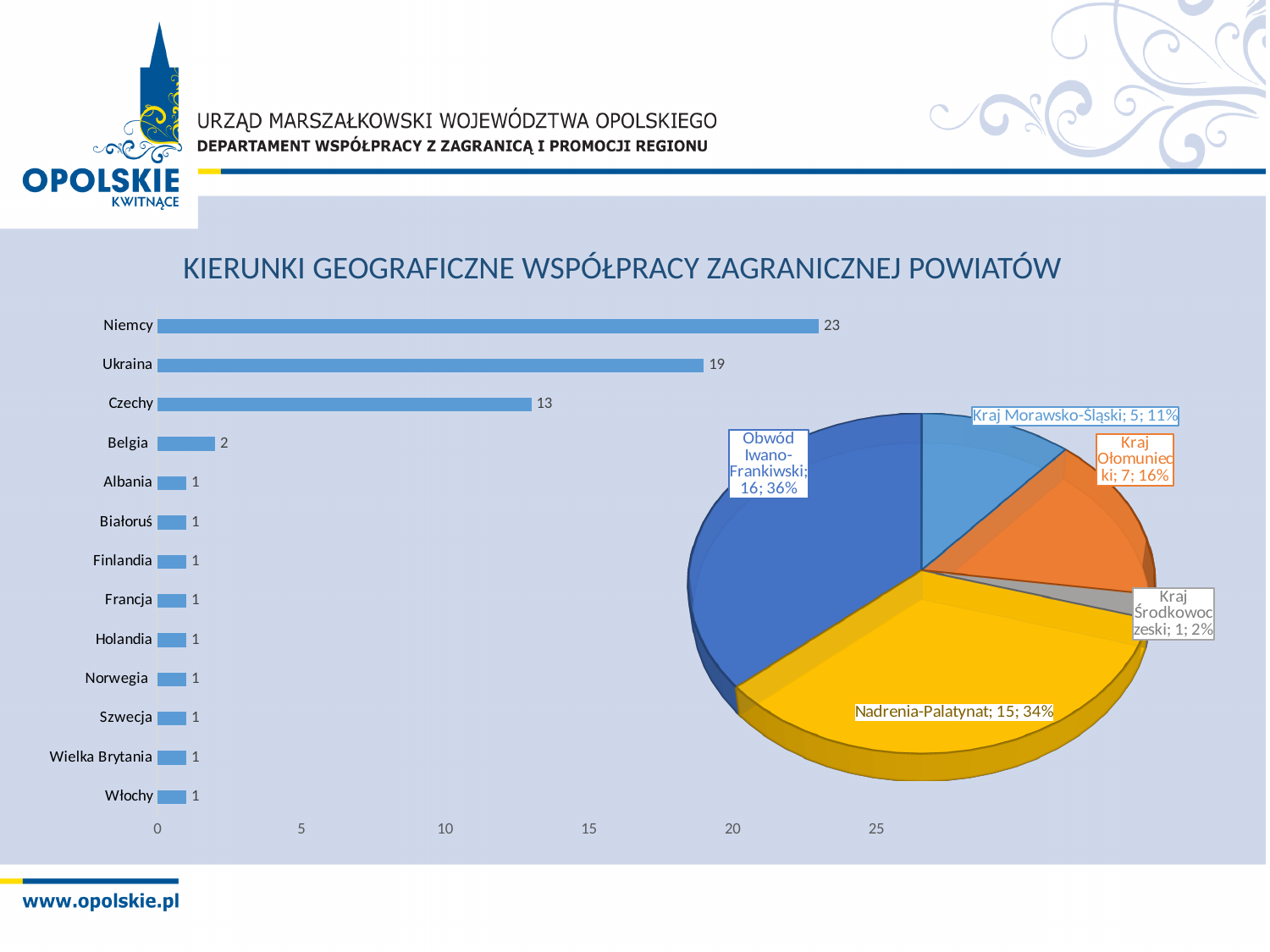
In the bar chart on the left, how many categories are shown? 13 In the bar chart on the left, which is larger, the value for Belgia or the value for Czechy? Czechy What is the title shown above the charts on the slide? KIERUNKI GEOGRAFICZNE WSPÓŁPRACY ZAGRANICZNEJ POWIATÓW In the pie chart on the right, which slice is the smallest? Kraj Środkowoczeski In the bar chart on the left, what is the difference between the values for Niemcy and Ukraina? 4 What kind of chart is the chart on the left of the slide? Bar chart In the bar chart on the left, what is the value for Niemcy? 23 In the pie chart on the right, what value is shown for Nadrenia-Palatynat? 15 In the bar chart on the left, what is the value for Czechy? 13 In the bar chart on the left, which category has the highest value? Niemcy In the pie chart on the right, what share does Obwód Iwano-Frankiwski have? 36% In the pie chart on the right, how many slices are there? 5